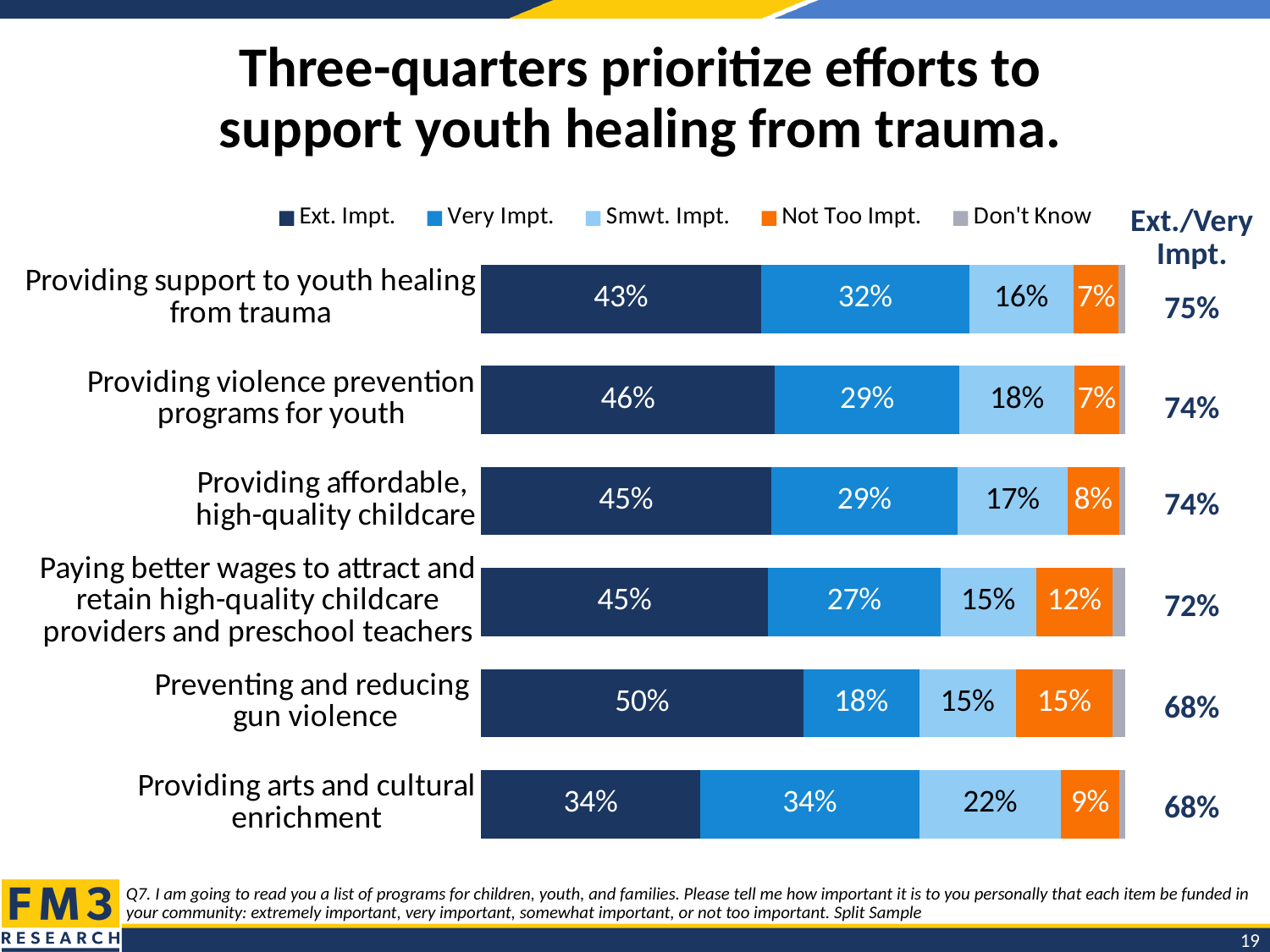
How many percentage points higher is the Ext. Impt. value for "Providing violence prevention programs for youth" than for "Providing support to youth healing from trauma"? 3 percentage points What percentage rated "Preventing and reducing gun violence" as Ext. Impt.? 50% What is the Very Impt. value for "Providing arts and cultural enrichment"? 34% What is the combined Ext./Very Impt. value for "Providing support to youth healing from trauma"? 75% How many response categories does the legend list? 5 What kind of chart is shown on the slide? Stacked bar chart Which item has the lowest Ext. Impt. percentage? Providing arts and cultural enrichment What is the Not Too Impt. value for "Paying better wages to attract and retain high-quality childcare providers and preschool teachers"? 12% Which has a larger Very Impt. value: "Providing support to youth healing from trauma" or "Preventing and reducing gun violence"? Providing support to youth healing from trauma Which item has the highest Ext. Impt. percentage? Preventing and reducing gun violence What is the Smwt. Impt. value for "Providing arts and cultural enrichment"? 22% How many program items are shown in the chart? 6